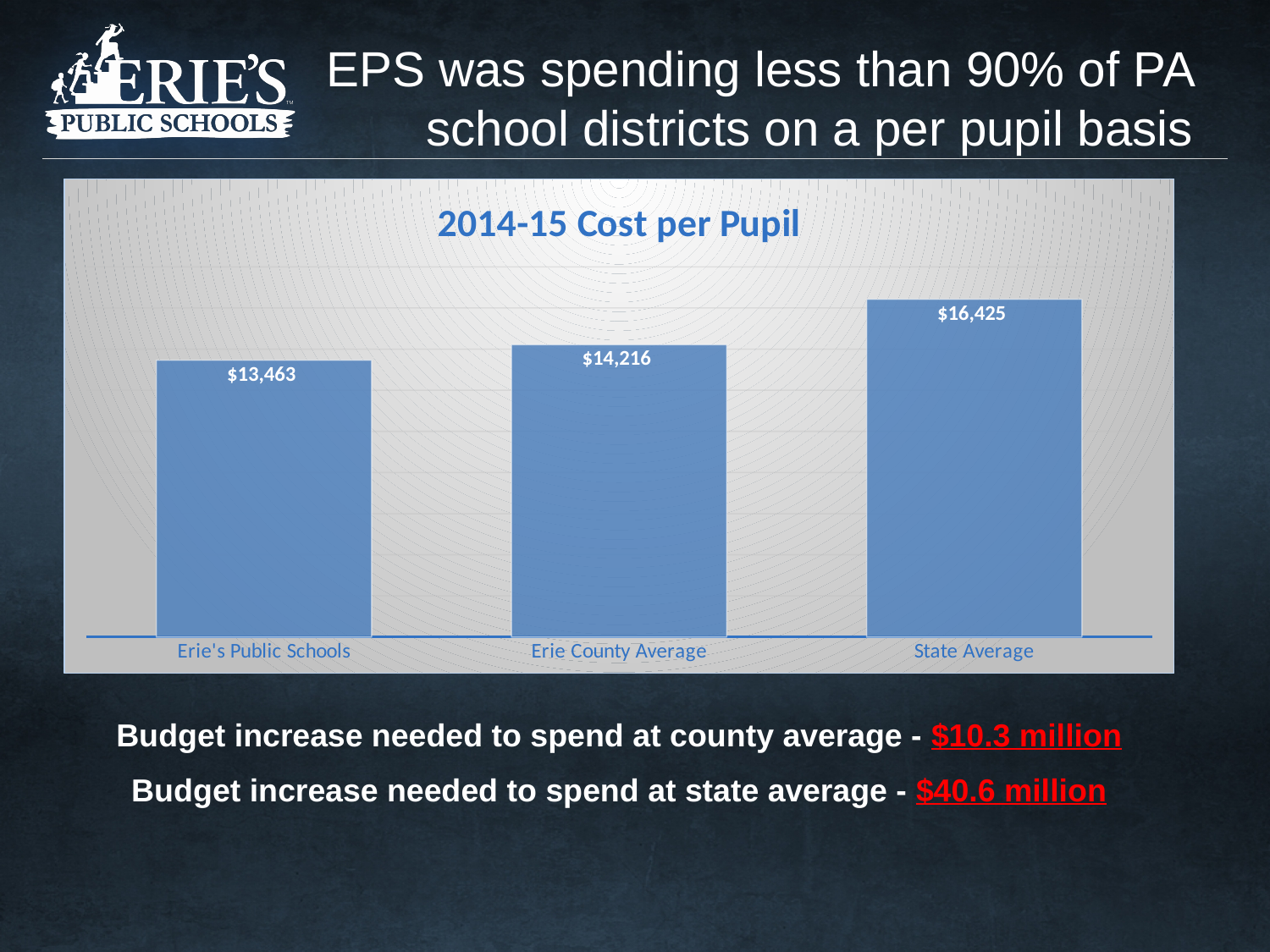
What is the 2014-15 cost per pupil for the Erie County Average? $14,216 Which is larger, the cost per pupil for the Erie County Average or for Erie's Public Schools? Erie County Average What kind of chart is shown on the slide? Bar chart What is the title of the chart? 2014-15 Cost per Pupil How many categories are shown in the chart? 3 What is the difference between the Erie County Average and Erie's Public Schools cost per pupil? $753 Which category has the highest cost per pupil? State Average Do the values rise or fall from left to right across the categories? Rise What is the difference between the State Average and Erie's Public Schools cost per pupil? $2,962 What is the 2014-15 cost per pupil for the State Average? $16,425 What is the 2014-15 cost per pupil for Erie's Public Schools? $13,463 Which category has the lowest cost per pupil? Erie's Public Schools